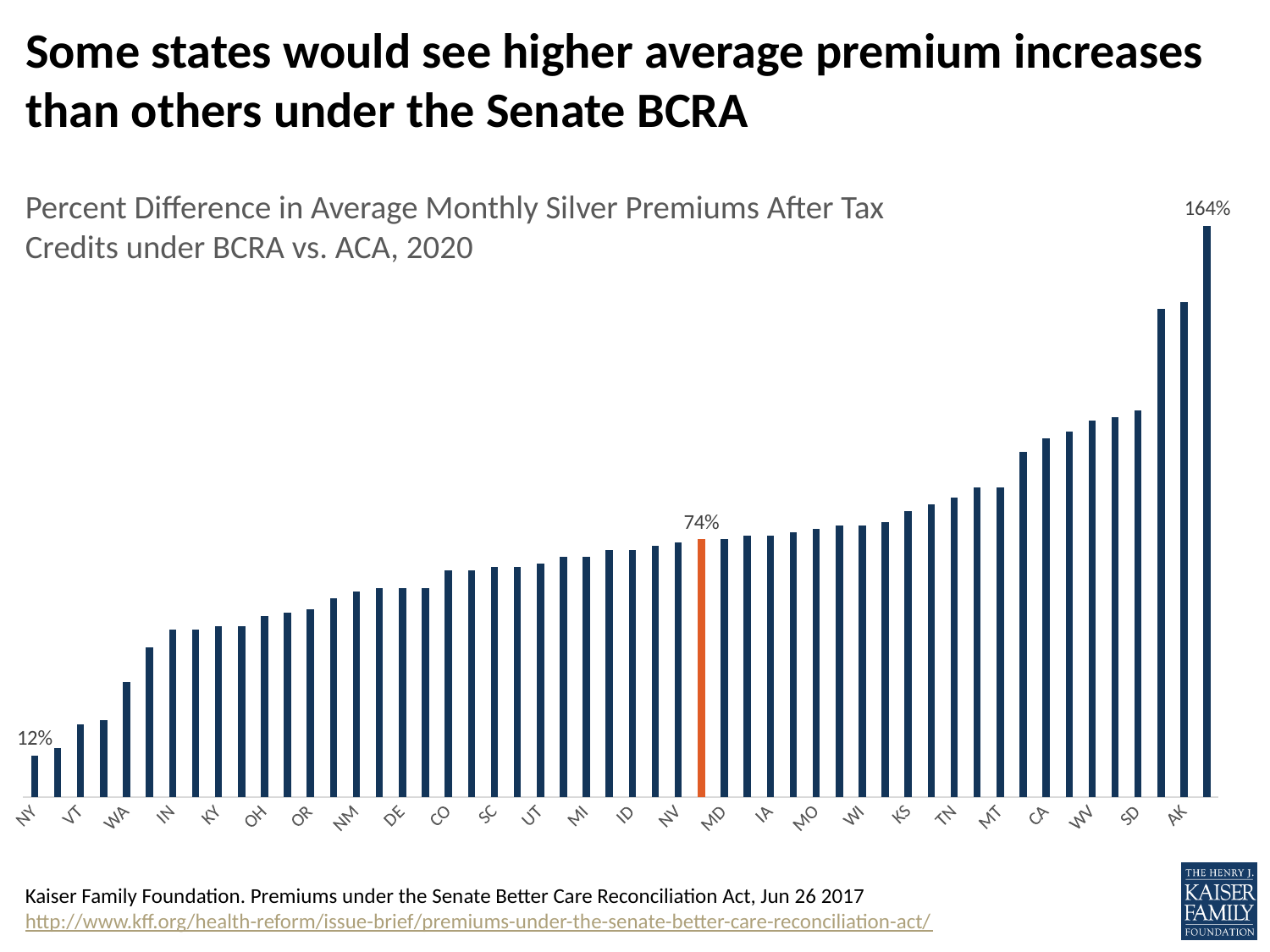
What is the highest value labeled on the chart? 164% What is the difference between the highest labeled value (164%) and the lowest labeled value (12%)? 152 percentage points Which has a larger value, AK or WA? AK Which state has the lowest value on the chart? NY Do the values rise or fall moving from left to right along the x axis? rise What is the subtitle describing the measure plotted in the chart? Percent Difference in Average Monthly Silver Premiums After Tax Credits under BCRA vs. ACA, 2020 What is the value for NY? 12% What colour is the single highlighted bar labeled 74%? orange What value is labeled on the orange highlighted bar? 74% Which has a larger value, NY or VT? VT What type of chart is shown on the slide? bar chart